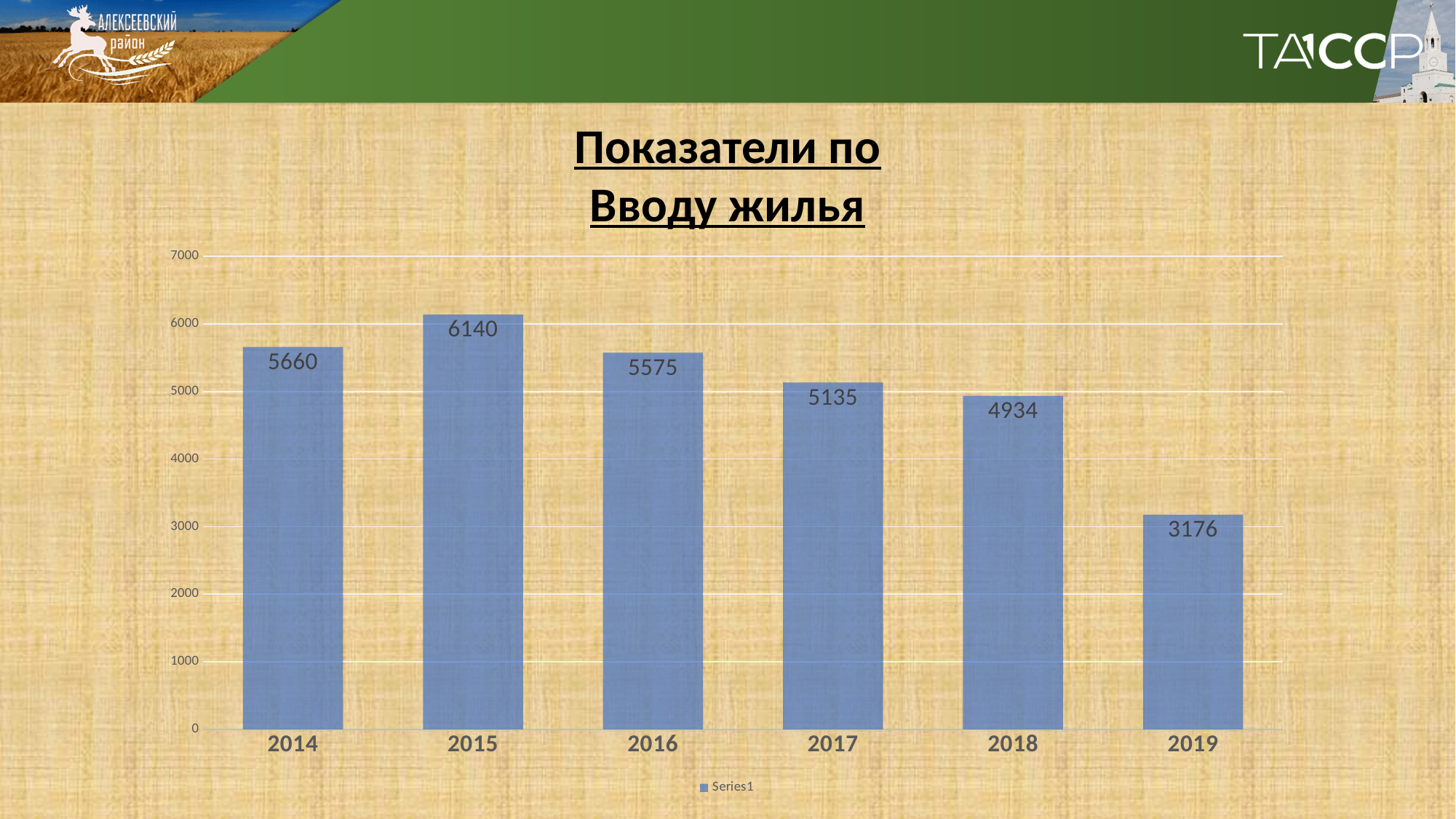
What kind of chart is shown on the slide? bar chart What is the value for 2019? 3176 What is the difference between the values for 2015 and 2019? 2964 Which year has the lowest value? 2019 What is the value for 2017? 5135 What is the value for 2015? 6140 Do the values rise or fall from 2015 to 2019? fall Is the value for 2018 greater or less than 5000? less Which year has the highest value? 2015 Which is larger, the value for 2017 or the value for 2018? 2017 How many years are shown on the x axis? 6 What is the difference between the values for 2014 and 2016? 85